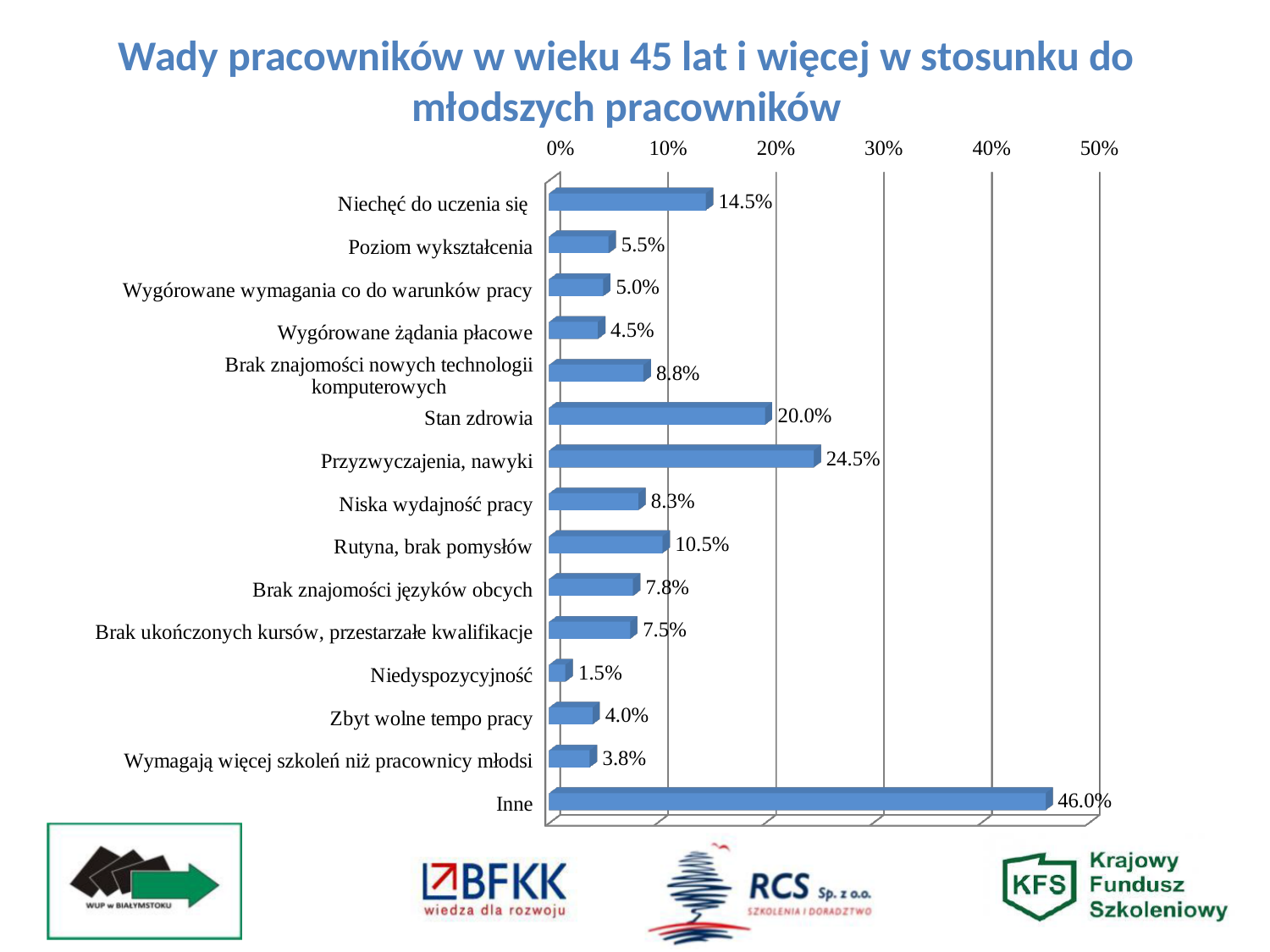
Is the value for "Inne" greater or less than 40%? greater What is the value for "Brak znajomości języków obcych"? 7.8% What is the difference between the values for "Przyzwyczajenia, nawyki" and "Stan zdrowia"? 4.5% What is the value for "Wymagają więcej szkoleń niż pracownicy młodsi"? 3.8% Which is larger: the value for "Rutyna, brak pomysłów" or the value for "Niska wydajność pracy"? Rutyna, brak pomysłów Which category has the lowest value? Niedyspozycyjność What is the title of the chart? Wady pracowników w wieku 45 lat i więcej w stosunku do młodszych pracowników What is the value for "Niechęć do uczenia się"? 14.5% How many categories are shown in the chart? 15 What is the value for "Stan zdrowia"? 20.0% Which category has the highest value? Inne What kind of chart is shown on the slide? bar chart